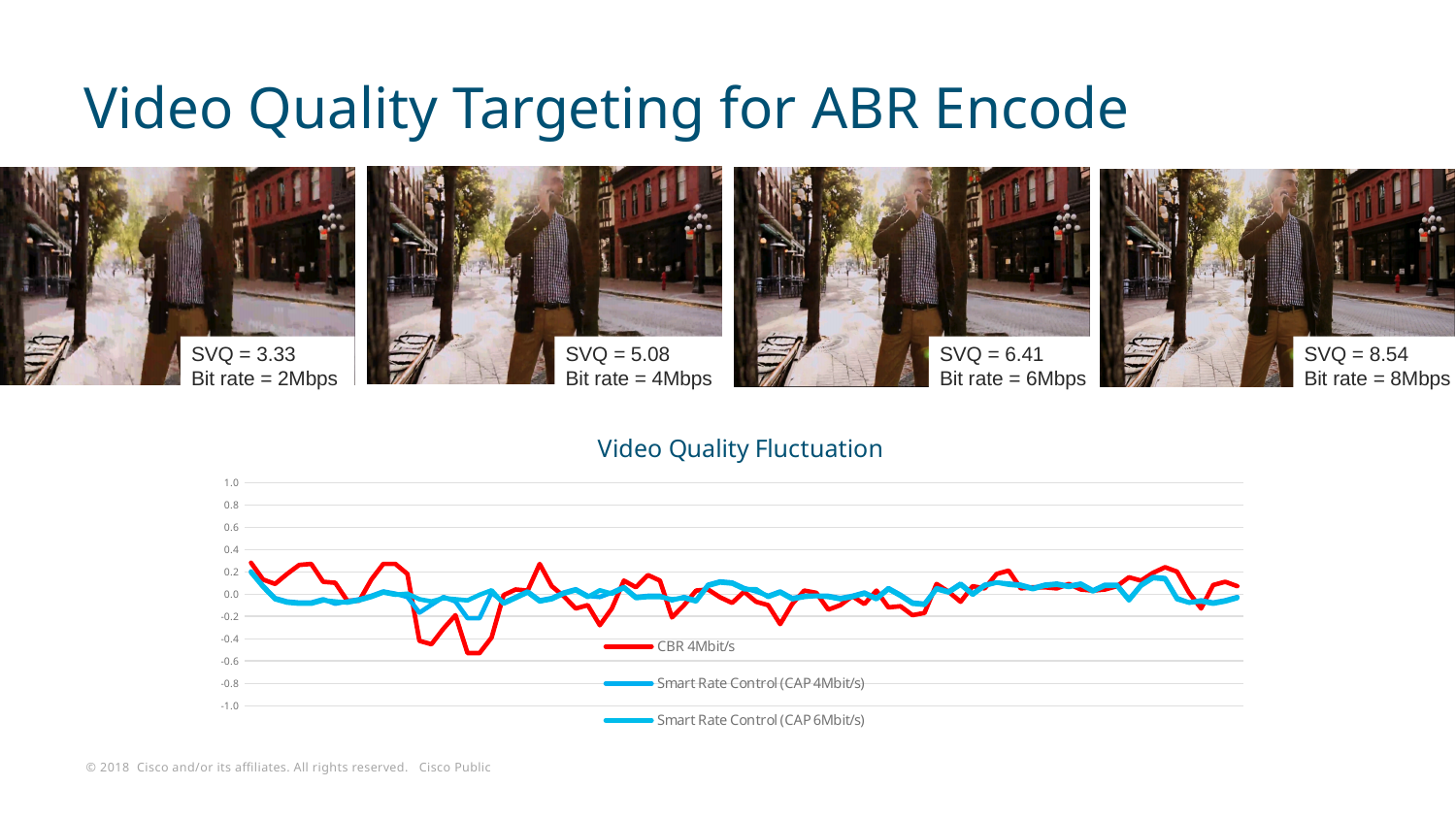
In the Video Quality Fluctuation chart, is the lowest value of the CBR 4Mbit/s line greater or less than -0.4? less What is the title of the chart on the slide? Video Quality Fluctuation In the Video Quality Fluctuation chart, is the lowest value of the Smart Rate Control (CAP 4Mbit/s) line greater or less than -0.6? greater In the Video Quality Fluctuation chart, is the highest value of the Smart Rate Control (CAP 6Mbit/s) line greater or less than 0.4? less What kind of chart is shown under the heading "Video Quality Fluctuation"? line chart How many series does the legend of the Video Quality Fluctuation chart list? 3 What is the highest tick value shown on the y axis of the Video Quality Fluctuation chart? 1.0 What is the lowest tick value shown on the y axis of the Video Quality Fluctuation chart? -1.0 In the Video Quality Fluctuation chart, what colour is the CBR 4Mbit/s line? red